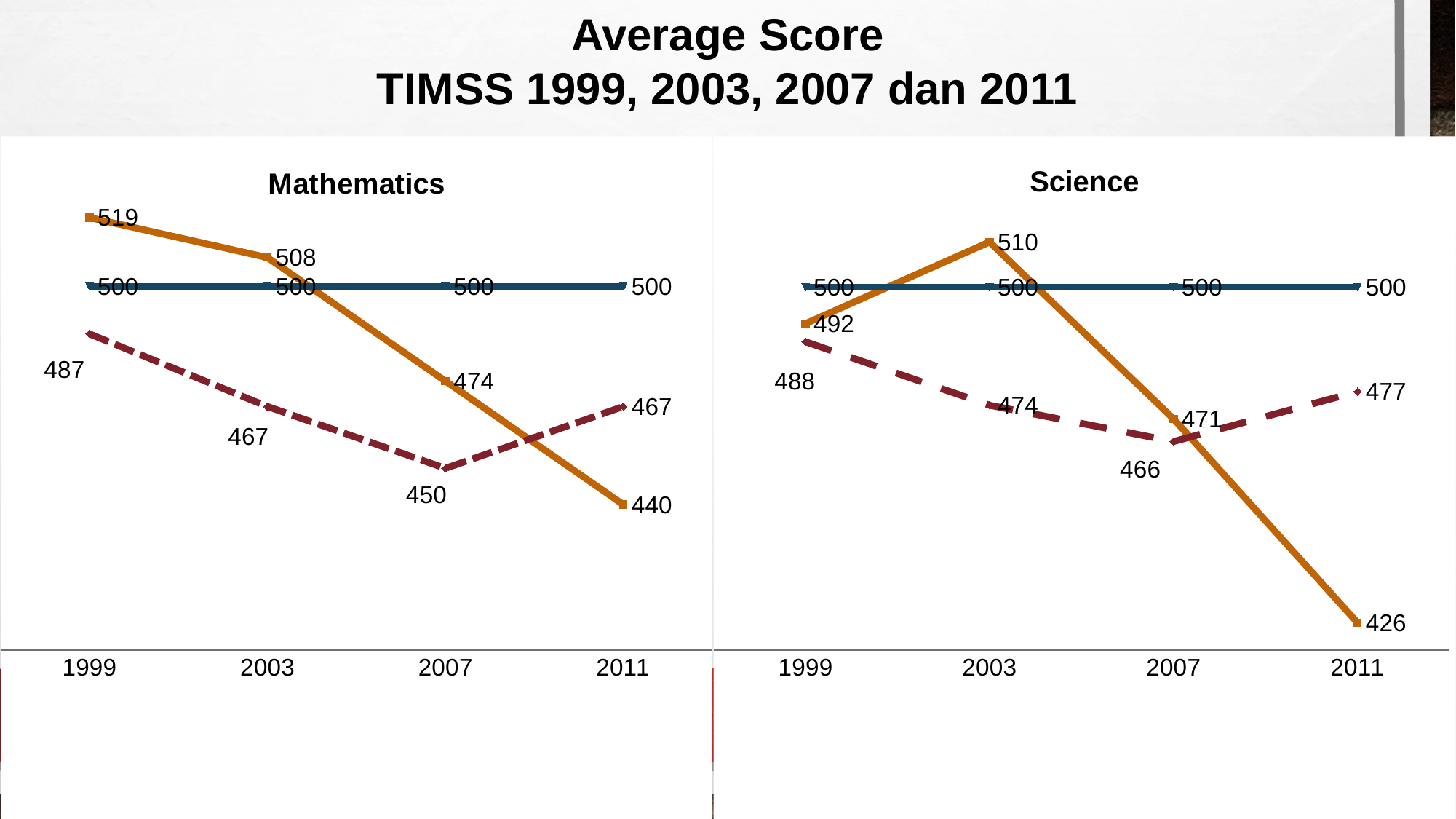
In the Science chart, what is the difference between the solid orange line's value in 2003 and its value in 2011? 84 In the Mathematics chart, in which year does the solid orange line reach its highest value? 1999 What type of chart is the Science chart? line chart In the Science chart, what is the value of the dashed line in 2011? 477 In the Mathematics chart, what is the value of the solid orange line in 2011? 440 In the Mathematics chart, what is the value of the dashed line in 2007? 450 How many years are shown on the x axis of the Mathematics chart? 4 In the Science chart, in which year does the solid orange line reach its lowest value? 2011 In the Science chart, which is larger in 2007: the solid orange line or the dashed line? the solid orange line In the Mathematics chart, what is the difference between the solid orange line's values in 1999 and 2011? 79 In the Science chart, what is the value of the solid orange line in 2003? 510 In the Mathematics chart, does the solid orange line rise or fall from 1999 to 2011? fall